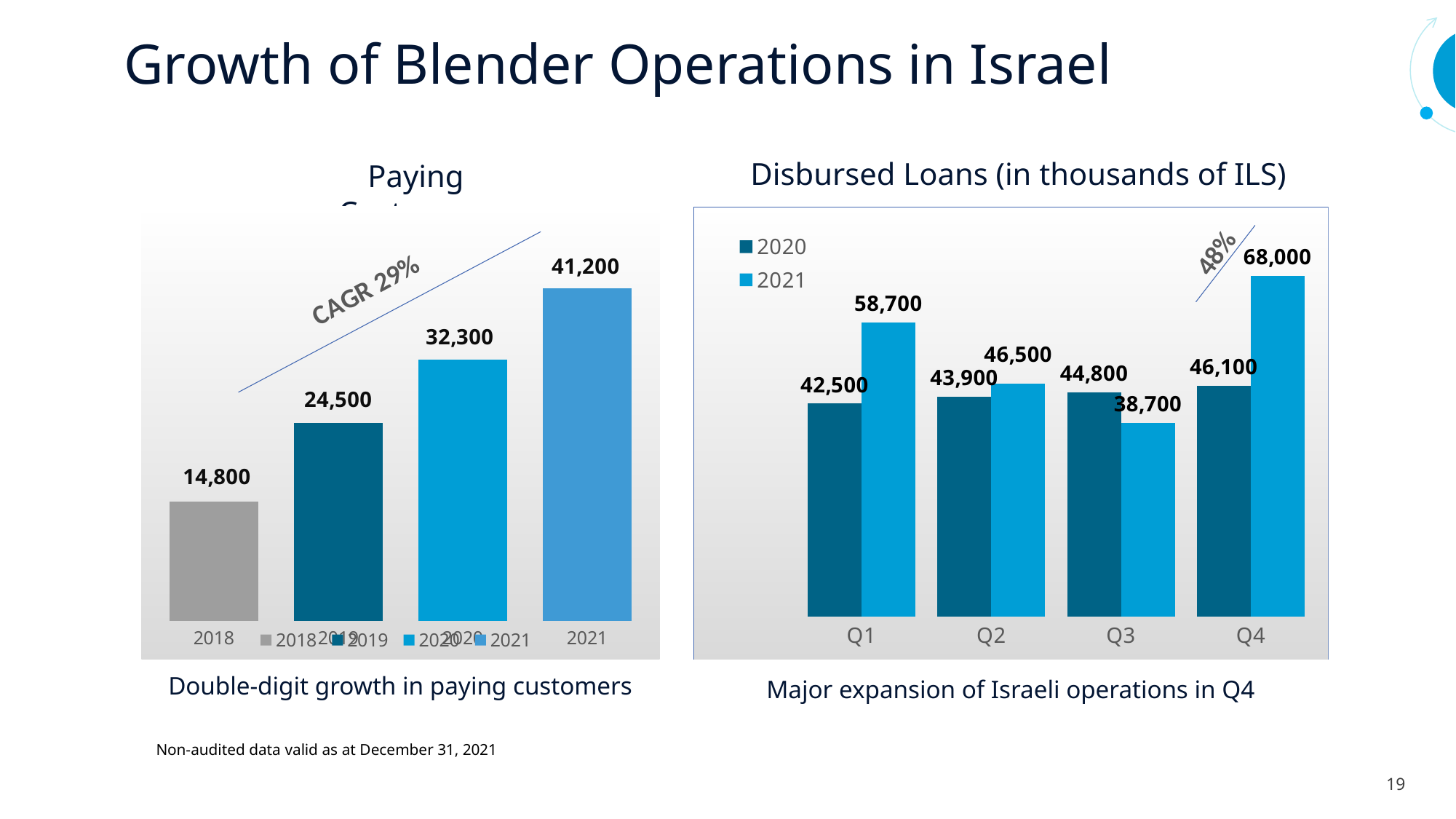
In the Disbursed Loans chart, which quarter has the lowest 2021 value? Q3 In the left chart (Paying Customers), what is the value for 2018? 14,800 In the left chart (Paying Customers), what CAGR is annotated on the chart? CAGR 29% In the Disbursed Loans chart, what is the 2020 value for Q2? 43,900 In the left chart (Paying Customers), which year has the lowest value? 2018 In the left chart (Paying Customers), what is the value for 2021? 41,200 In the left chart (Paying Customers), what is the difference between the 2021 and 2020 values? 8,900 In the left chart (Paying Customers), do the values rise or fall from 2018 to 2021? rise In the Disbursed Loans chart, what is the difference between the 2021 and 2020 values for Q4? 21,900 In the Disbursed Loans chart, which is larger for Q3: the 2020 value or the 2021 value? 2020 In the Disbursed Loans chart, what is the 2021 value for Q4? 68,000 How many series does the legend of the Disbursed Loans chart list? 2